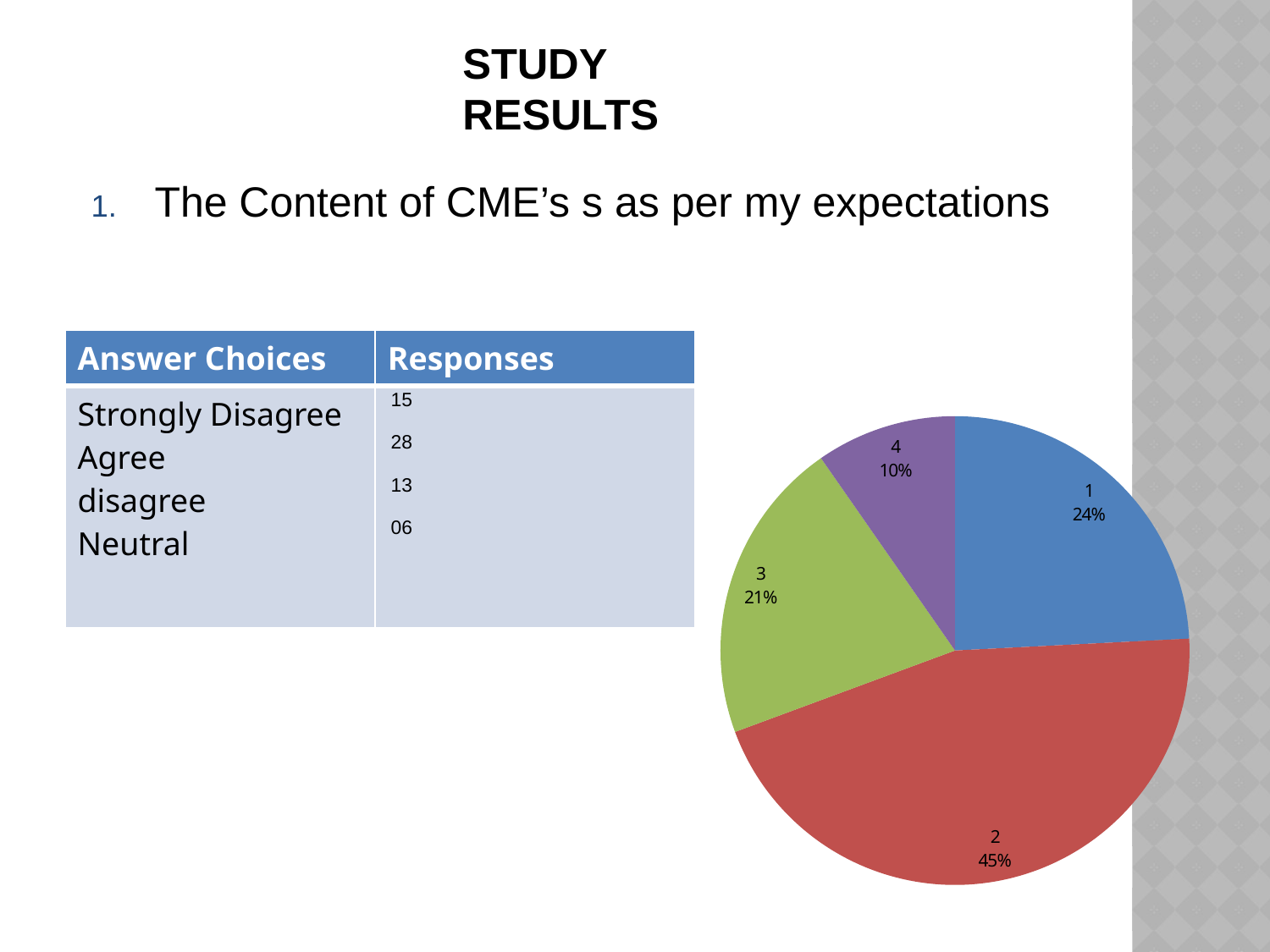
Which slice is larger in the pie chart, slice 1 or slice 3? 1 Which slice of the pie chart is the smallest? 4 What is the difference in percentage points between slice 3 and slice 4 in the pie chart? 11 What percentage share does slice 2 have in the pie chart? 45% How many slices does the pie chart have? 4 What percentage share does slice 4 have in the pie chart? 10% What colour is the largest slice of the pie chart? red What kind of chart is shown on the slide? pie chart What percentage share does slice 3 have in the pie chart? 21% Which slice of the pie chart is the largest? 2 What is the difference in percentage points between slice 2 and slice 1 in the pie chart? 21